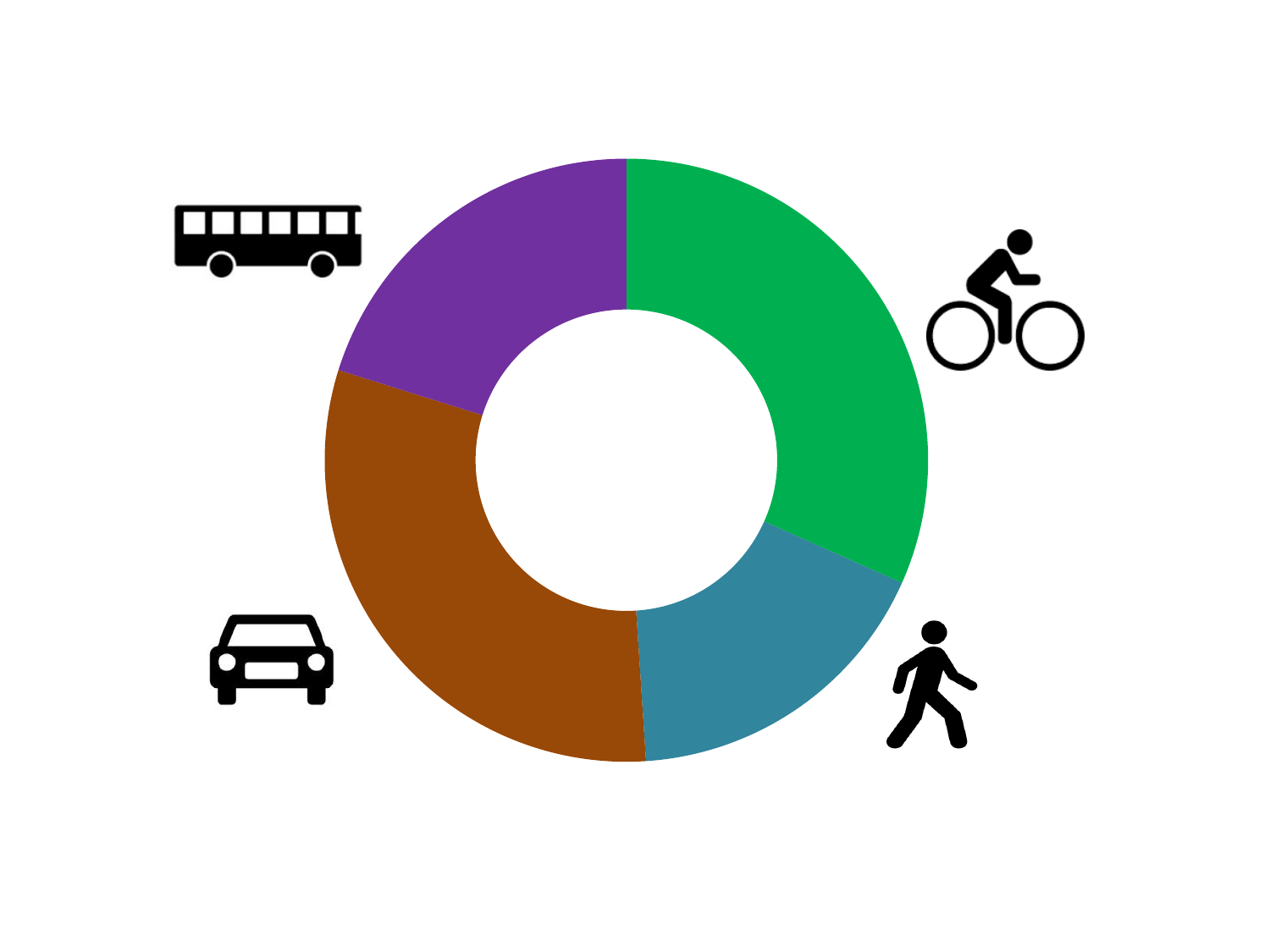
Which slice is larger, the brown slice or the purple slice? brown Which slice is larger, the green slice or the purple slice? green What colour is the slice positioned next to the car icon? brown How many slices does the doughnut chart have? 4 What kind of chart is shown on the slide? doughnut chart What colour is the slice positioned next to the bicycle icon? green Which slice is larger, the brown slice or the teal slice? brown